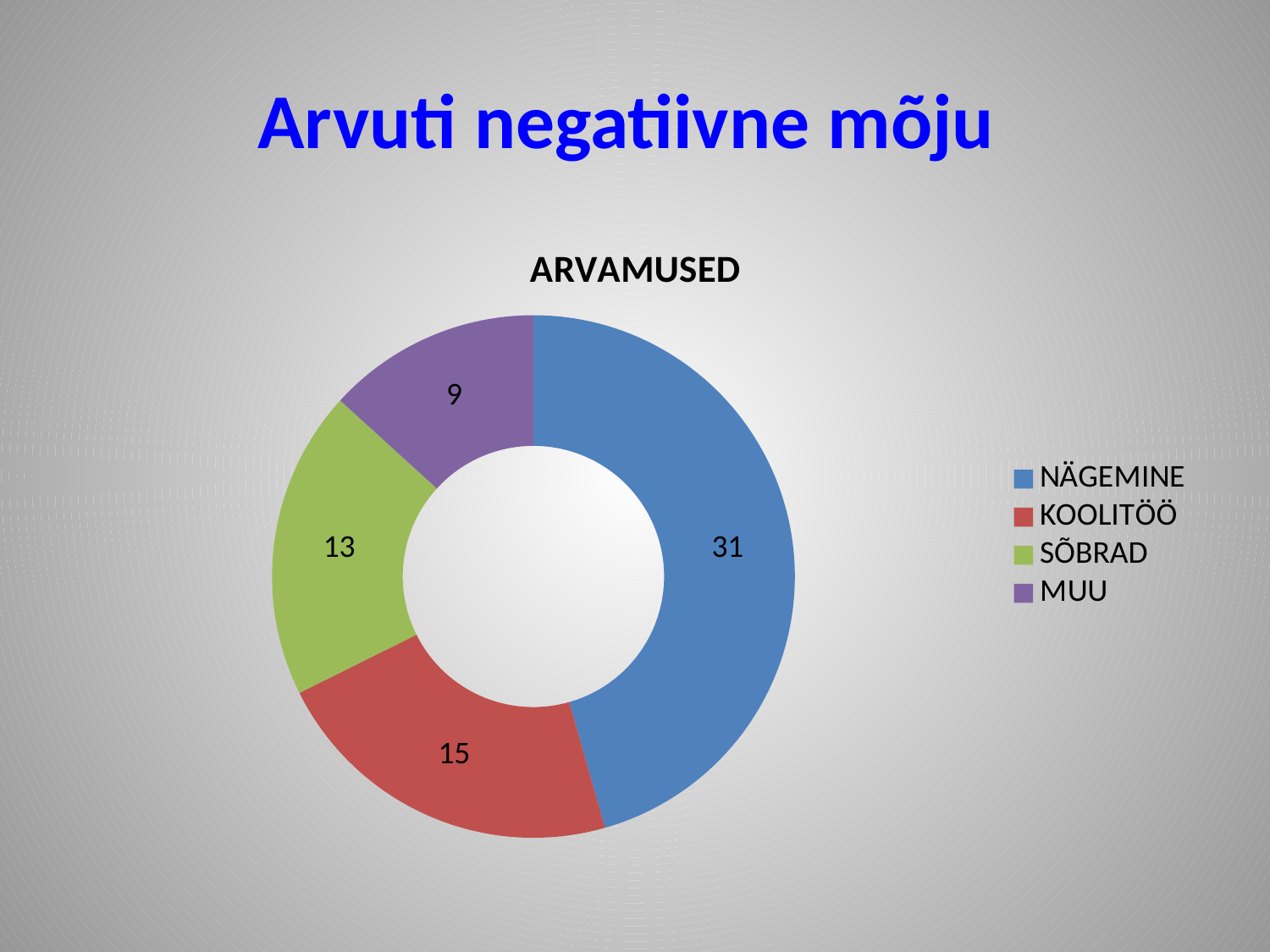
What is the difference between the values for NÄGEMINE and KOOLITÖÖ? 16 Which is larger, the value for SÕBRAD or the value for MUU? SÕBRAD What is the value for KOOLITÖÖ? 15 What is the value for NÄGEMINE? 31 What is the total of all the values in the chart? 68 Which category has the lowest value? MUU Which category has the highest value? NÄGEMINE What is the title of the chart? ARVAMUSED What type of chart is shown on the slide? doughnut chart What is the value for MUU? 9 What is the value for SÕBRAD? 13 How many categories does the chart show? 4